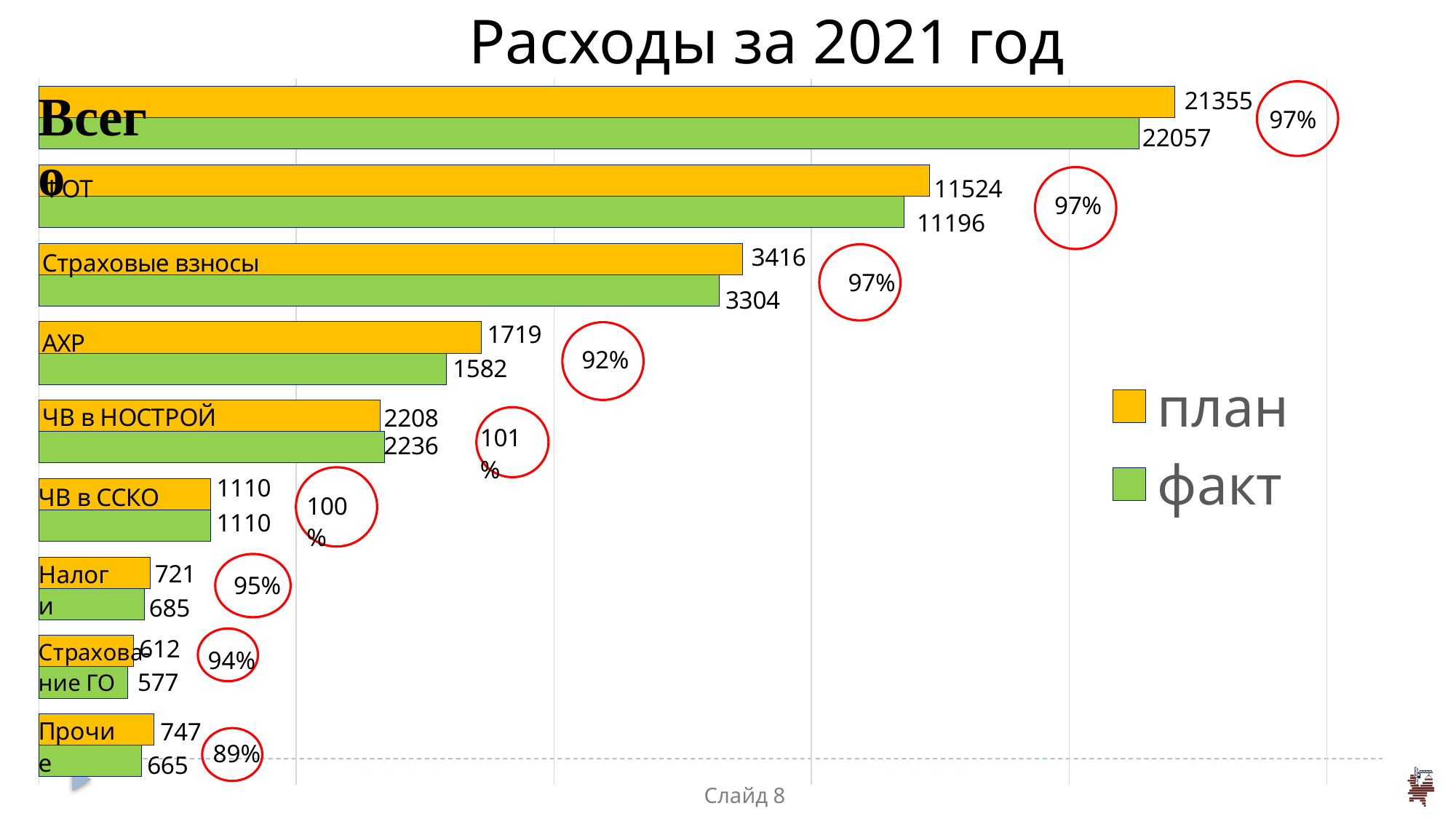
Which is larger for ЧВ в НОСТРОЙ, the план value or the факт value? факт What is the факт value for Налоги? 685 How many series does the legend list? 2 Which colour represents the факт series in the legend? green Excluding Всего, which category has the highest план value? ФОТ What is the факт value for АХР? 1582 What type of chart is shown on the slide? bar chart What is the план value for Страховые взносы? 3416 What percentage is shown in the circle next to АХР? 92% What is the difference between the план and факт values for ФОТ? 328 What is the план value for ЧВ в НОСТРОЙ? 2208 Which category has the lowest факт value? Страхование ГО